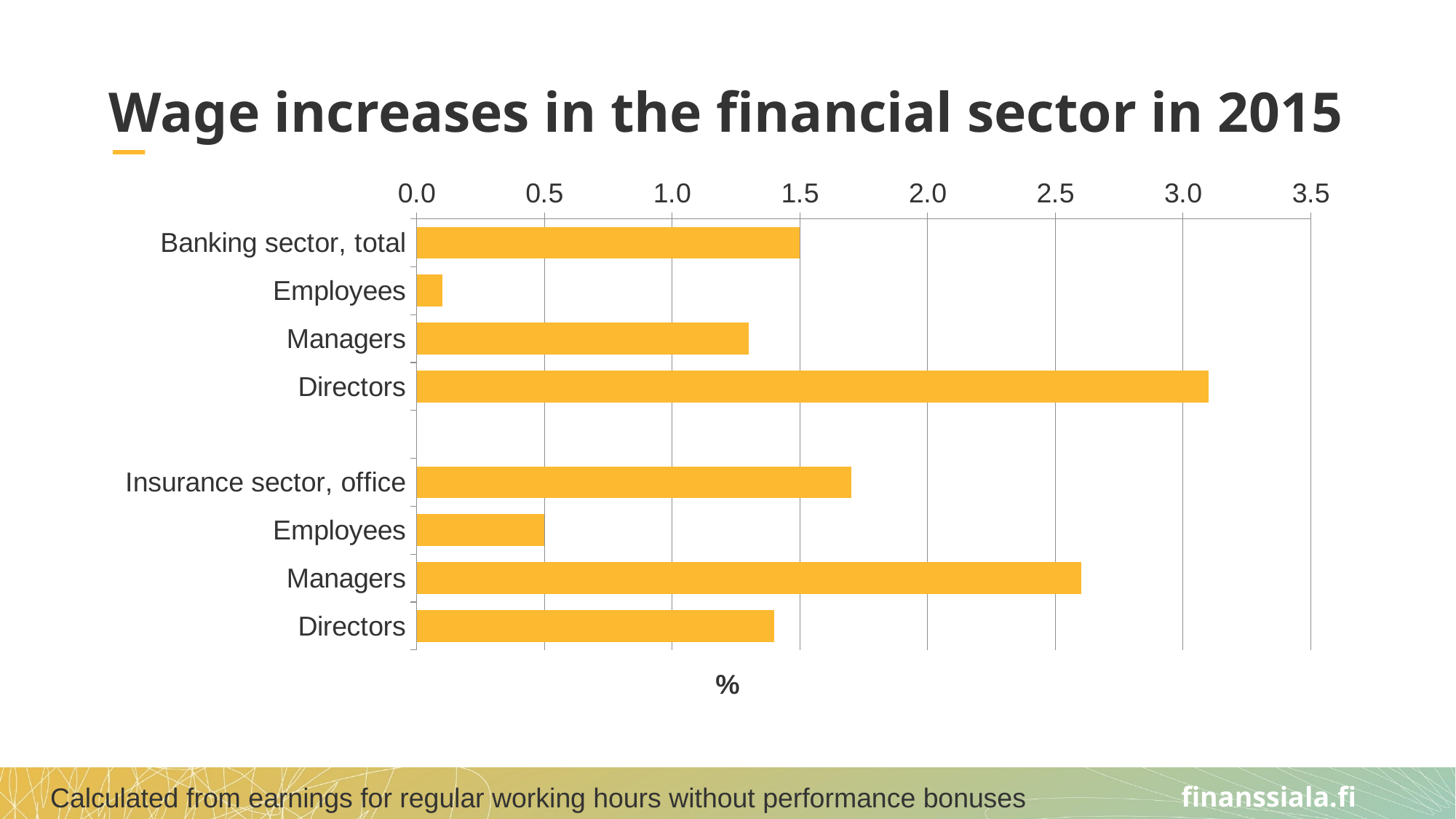
Is the wage increase for Managers in the insurance sector greater or less than 2.5? greater What kind of chart is shown on the slide? bar chart Is the wage increase for Employees in the banking sector greater or less than 0.5? less How many bars are plotted in the chart? 8 Is the wage increase for Directors in the banking sector greater or less than 3.0? greater Which is larger: the wage increase for Directors in the banking sector or for Directors in the insurance sector? Directors in the banking sector Which category has the lowest wage increase? Employees (banking sector) What unit is shown on the horizontal axis label? % Which category has the highest wage increase? Directors (banking sector) What is the title of the chart? Wage increases in the financial sector in 2015